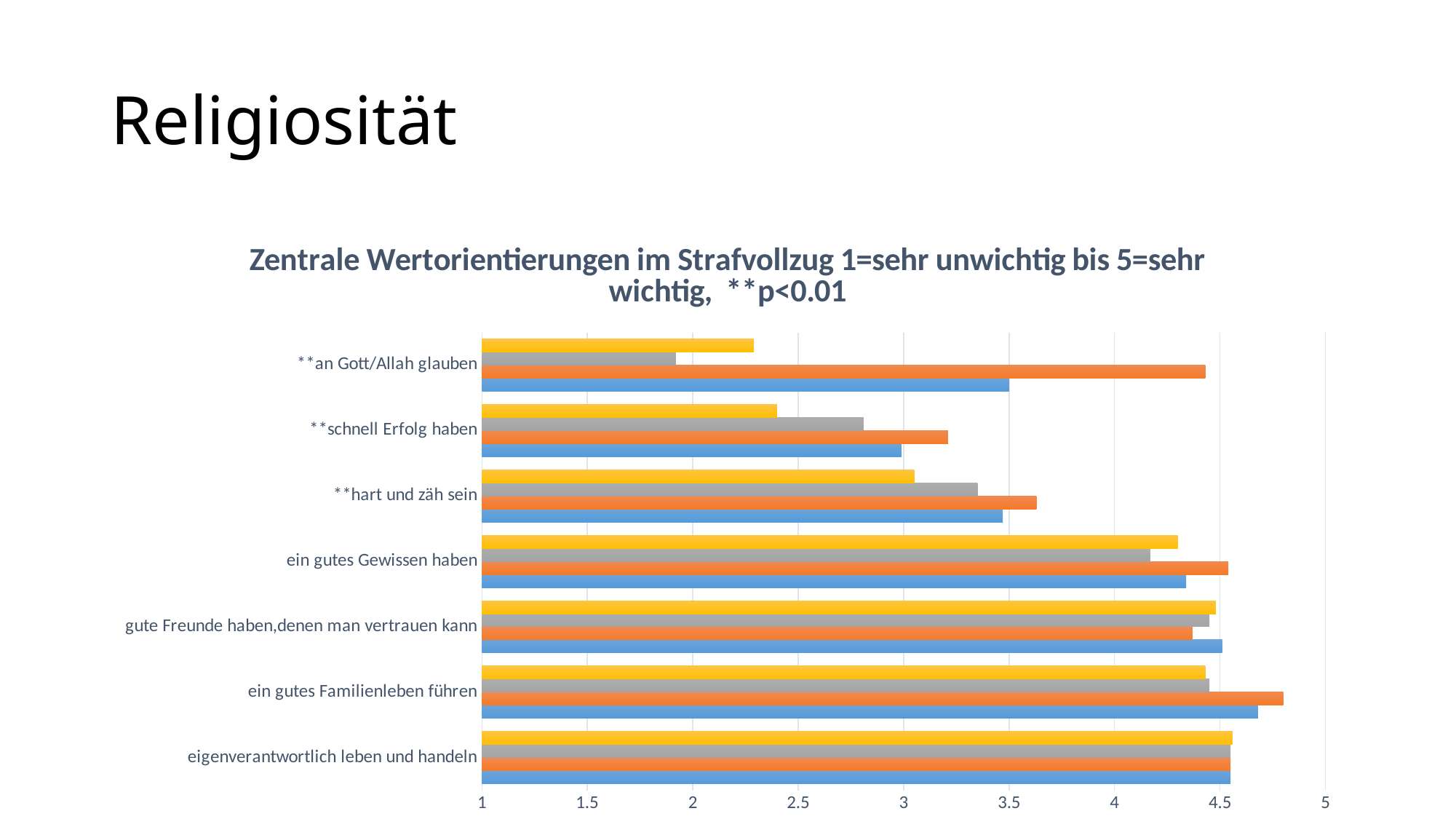
Is the yellow bar for "**schnell Erfolg haben" greater or less than 2.5? less How many bars are shown for each category in the chart? 4 What kind of chart is shown on the slide? bar chart How many categories are plotted on the vertical axis of the chart? 7 Is the orange bar for "**an Gott/Allah glauben" greater or less than 4? greater Is the gray bar for "**an Gott/Allah glauben" greater or less than 2? less What is the title of the chart? Zentrale Wertorientierungen im Strafvollzug 1=sehr unwichtig bis 5=sehr wichtig, **p<0.01 What is the highest value shown on the horizontal axis of the chart? 5 For "ein gutes Familienleben führen", which coloured bar is the longest? the orange bar For "**an Gott/Allah glauben", which is larger: the orange bar or the gray bar? the orange bar